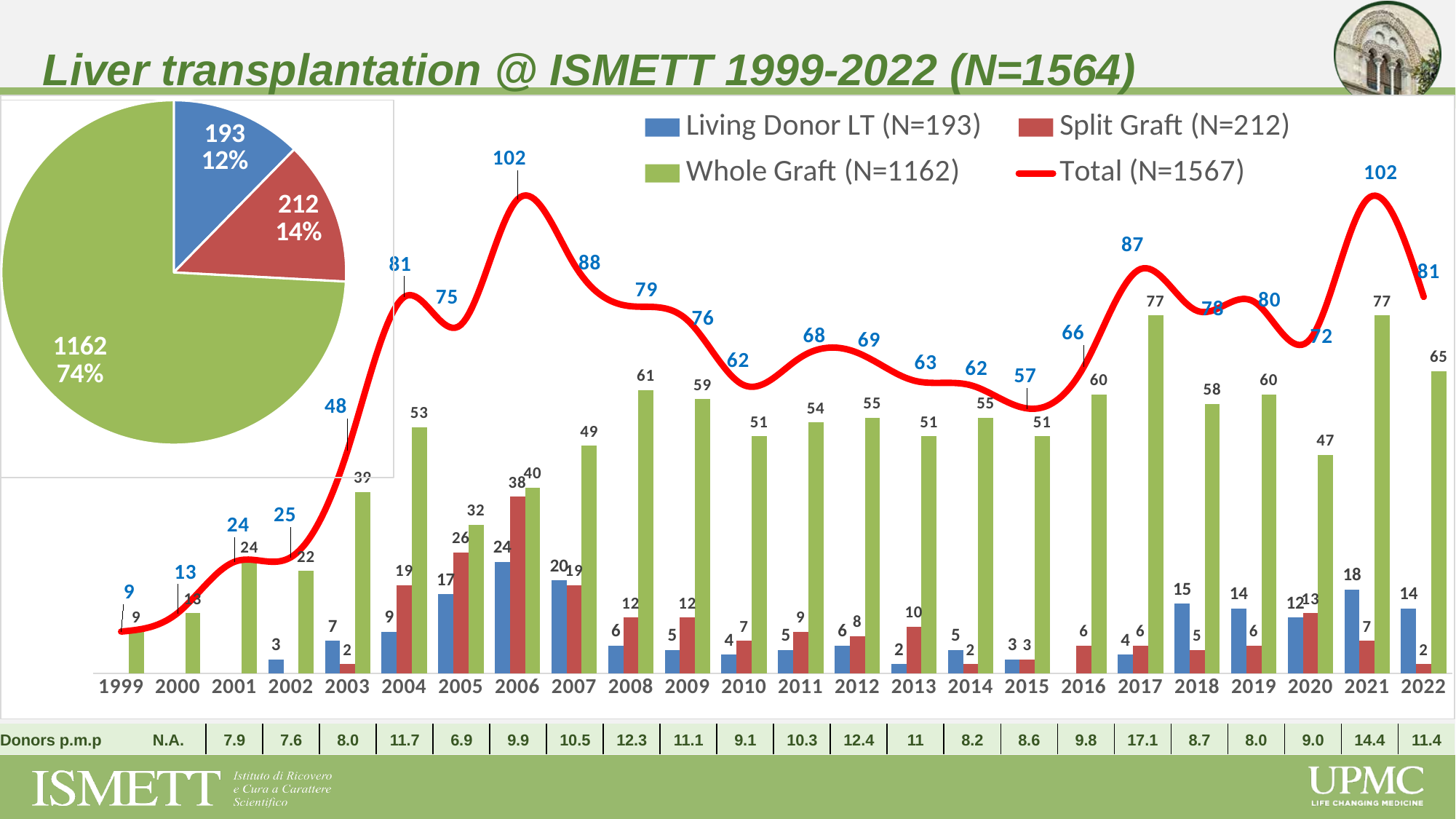
In the bar chart, does the Total line rise or fall from 2006 to 2010? fall In the bar chart, what is the difference between the Total value for 2021 and the Total value for 2020? 30 How many years are shown on the x axis of the bar chart? 24 How many series does the legend of the bar chart list? 4 In the pie chart, what share of liver transplants were Whole Graft? 74% In the pie chart, what is the value shown for the Split Graft slice? 212 In the bar chart, which year has the lowest Total value? 1999 In the bar chart, what is the Whole Graft value for 2008? 61 In the bar chart, what is the Living Donor LT value for 2021? 18 In the bar chart, what is the Split Graft value for 2006? 38 In the bar chart, which year has the highest Living Donor LT value? 2006 In the bar chart, what is the Total value for 2006? 102